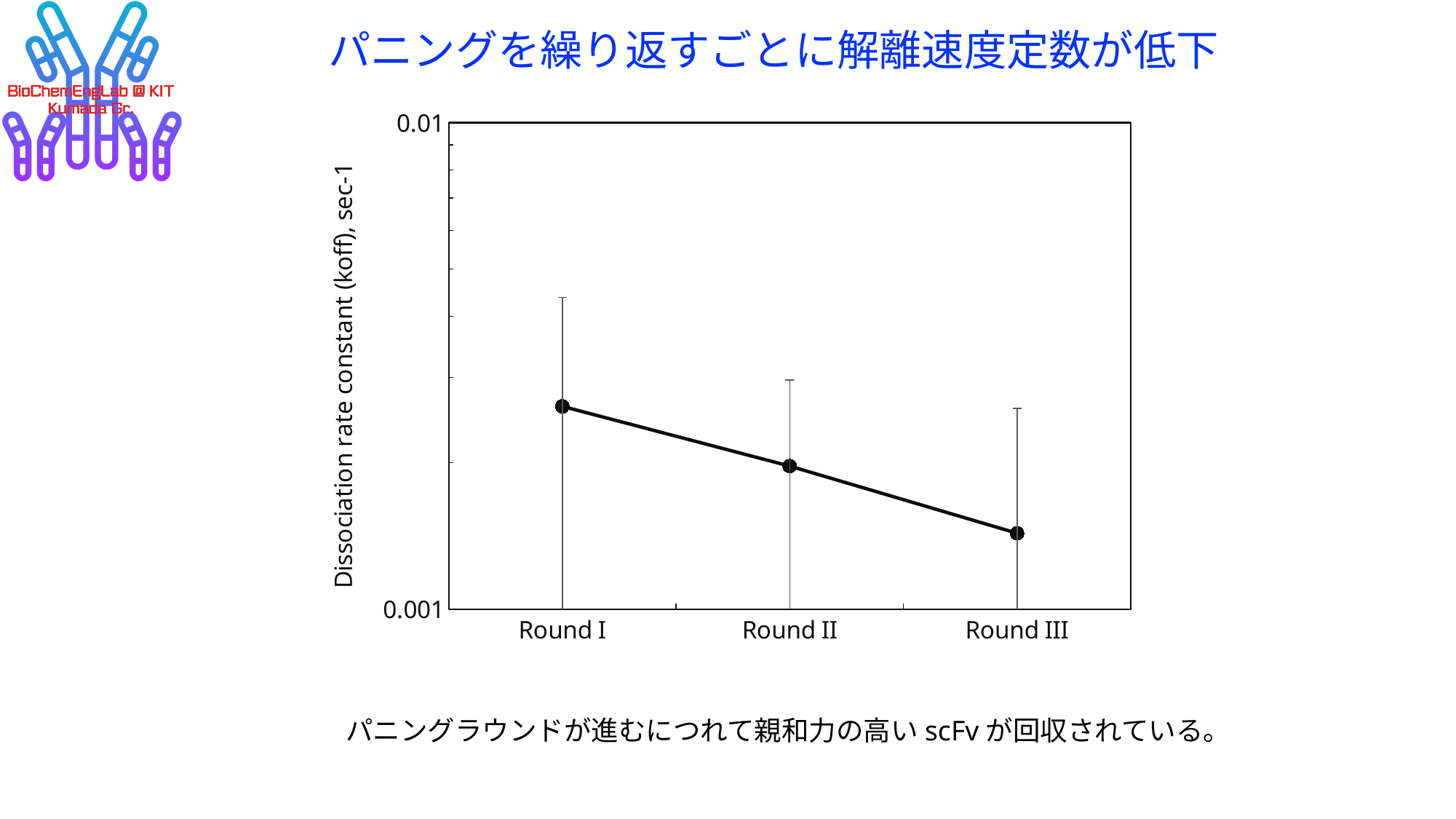
Which has the larger dissociation rate constant, Round II or Round III? Round II Which round has the highest dissociation rate constant? Round I What is the label of the y axis? Dissociation rate constant (koff), sec-1 Is the value for Round III greater or less than 0.001? greater What are the labels on the x axis, from left to right? Round I, Round II, Round III Which has the larger dissociation rate constant, Round I or Round III? Round I Is the value for Round I greater or less than 0.01? less Which round has the lowest dissociation rate constant? Round III What kind of chart is shown on the slide? line chart How many rounds are plotted on the x axis? 3 Do the plotted values rise or fall from Round I to Round III? fall